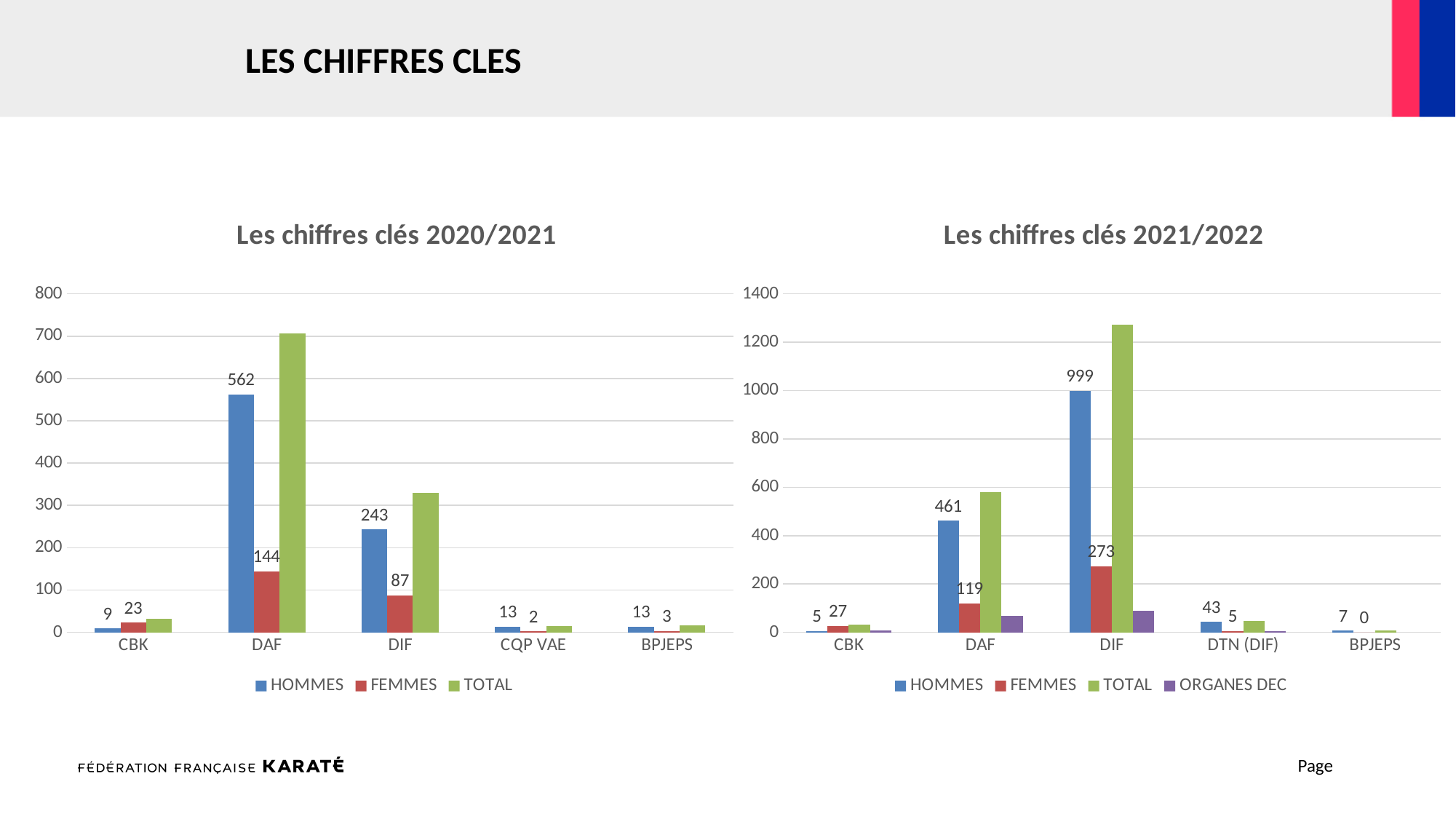
In the chart titled "Les chiffres clés 2021/2022", what is the FEMMES value for DAF? 119 What kind of chart is the chart titled "Les chiffres clés 2021/2022"? Bar chart In the chart titled "Les chiffres clés 2020/2021", how many categories are shown on the x axis? 5 In the chart titled "Les chiffres clés 2021/2022", how many series does the legend list? 4 In the chart titled "Les chiffres clés 2020/2021", what is the difference between the HOMMES and FEMMES values for DAF? 418 In the chart titled "Les chiffres clés 2020/2021", what is the FEMMES value for DIF? 87 In the chart titled "Les chiffres clés 2021/2022", which category has the lowest FEMMES value? BPJEPS In the chart titled "Les chiffres clés 2020/2021", what is the HOMMES value for DAF? 562 In the chart titled "Les chiffres clés 2020/2021", is the TOTAL value for DAF greater or less than 600? greater In the chart titled "Les chiffres clés 2021/2022", what is the HOMMES value for DIF? 999 In the chart titled "Les chiffres clés 2021/2022", is the TOTAL value for DIF greater or less than 1200? greater In the chart titled "Les chiffres clés 2020/2021", which category has the highest HOMMES value? DAF